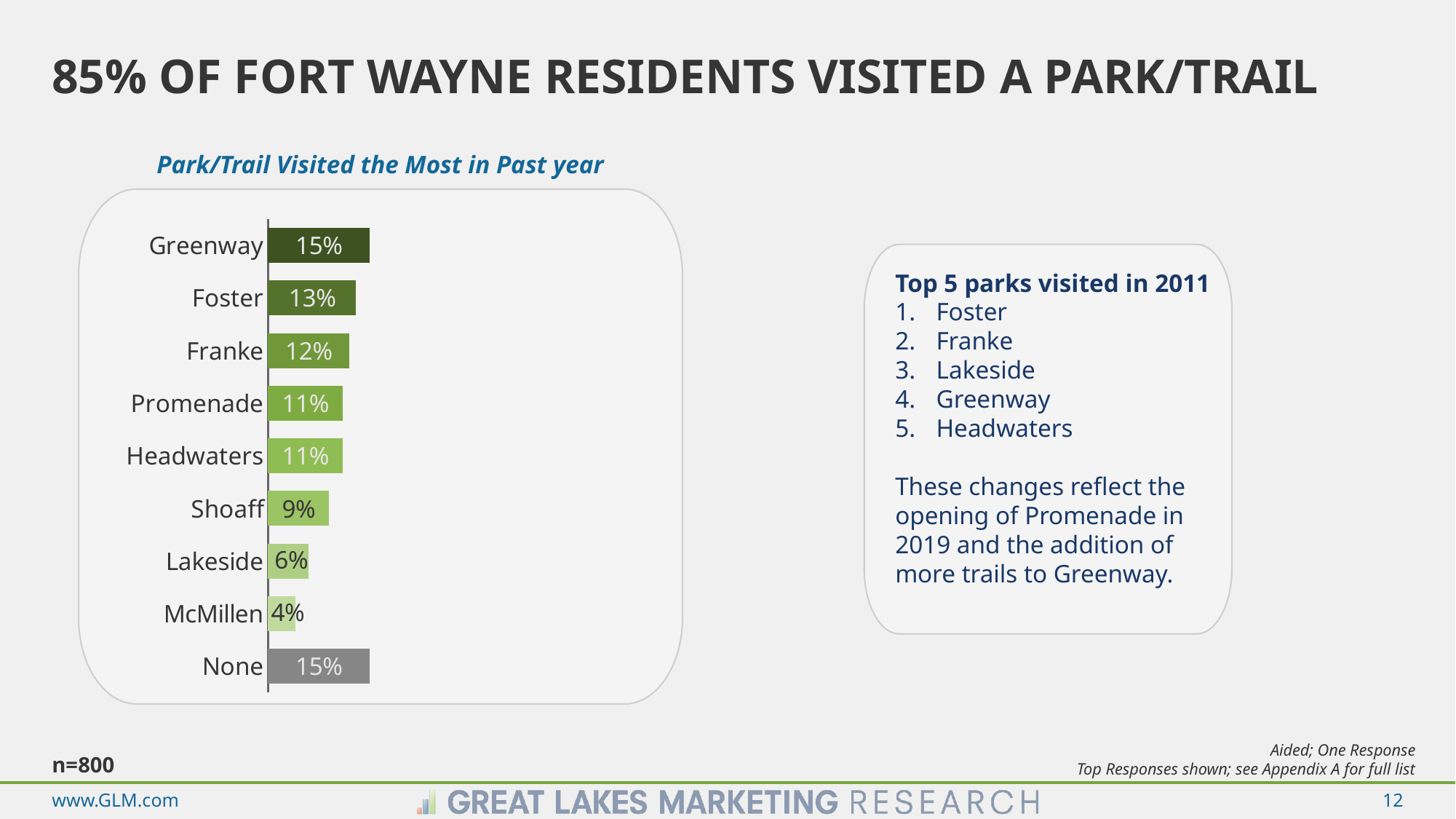
What percentage of respondents answered 'None'? 15% Which category has the lowest value in the chart? McMillen What type of chart is shown on the slide? Bar chart What value is shown for Foster in the chart? 13% What is the title of the chart? Park/Trail Visited the Most in Past year How many categories are shown in the chart? 9 Which has a higher value, Franke or Shoaff? Franke Which has a higher value, Foster or Franke? Foster What percentage of respondents said Greenway was the park/trail they visited the most in the past year? 15% What is the difference between the values for Greenway and Foster? 2 percentage points What is the difference between the values for Lakeside and McMillen? 2 percentage points What percentage is shown for Shoaff? 9%